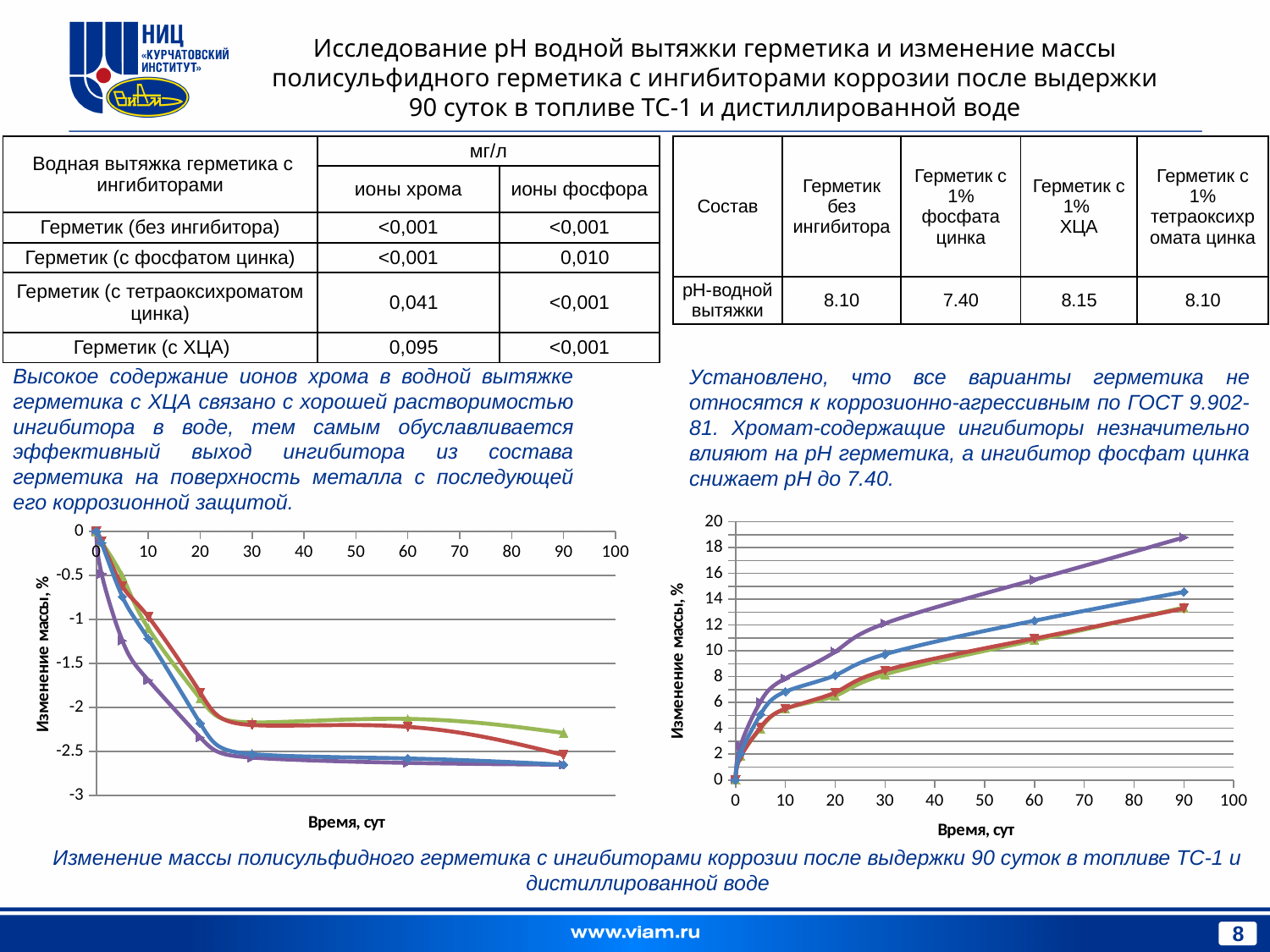
In the right chart, is the value of the purple series at 90 days greater or less than 18? greater What kind of chart is the right chart at the bottom of the slide? line chart In the left chart, is the value of the purple series at 90 days greater or less than -2.5? less In the right chart, which is larger at 90 days: the blue series or the red series? blue What kind of chart is the left chart at the bottom of the slide? line chart What is the label of the y axis on both charts? Изменение массы, % In the right chart, is the value of the red series at 90 days greater or less than 14? less In the left chart, do the plotted values rise or fall as time increases along the x axis? fall In the right chart, which coloured series has the highest value at 90 days? purple In the right chart, do the plotted values rise or fall as time increases along the x axis? rise What is the label of the x axis on both charts? Время, сут